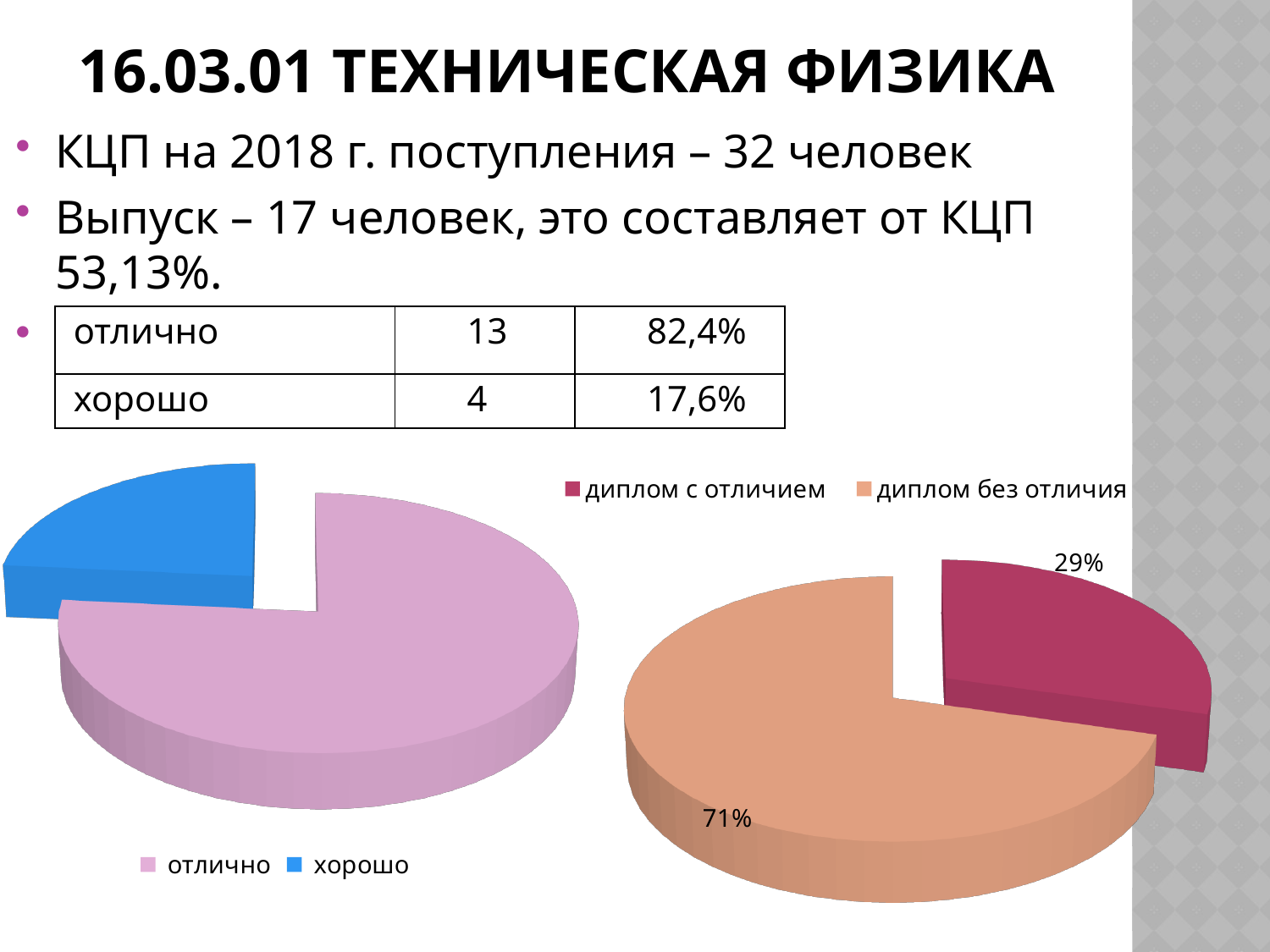
In the right chart, what share is labelled for 'диплом без отличия'? 71% How many slices does the left chart have? 2 What kind of chart is the left chart with the legend 'отлично' and 'хорошо'? pie chart What kind of chart is the right chart with the legend 'диплом с отличием' and 'диплом без отличия'? pie chart In the left chart, which slice is larger, 'отлично' or 'хорошо'? отлично In the right chart, which slice is the largest? диплом без отличия In the right chart, what share is labelled for 'диплом с отличием'? 29% In the left chart, what colour is the 'хорошо' slice? blue In the left chart, which category has the smallest slice? хорошо In the right chart, which slice is the smallest? диплом с отличием How many entries does the legend of the right chart list? 2 In the right chart, what is the difference in percentage points between 'диплом без отличия' and 'диплом с отличием'? 42